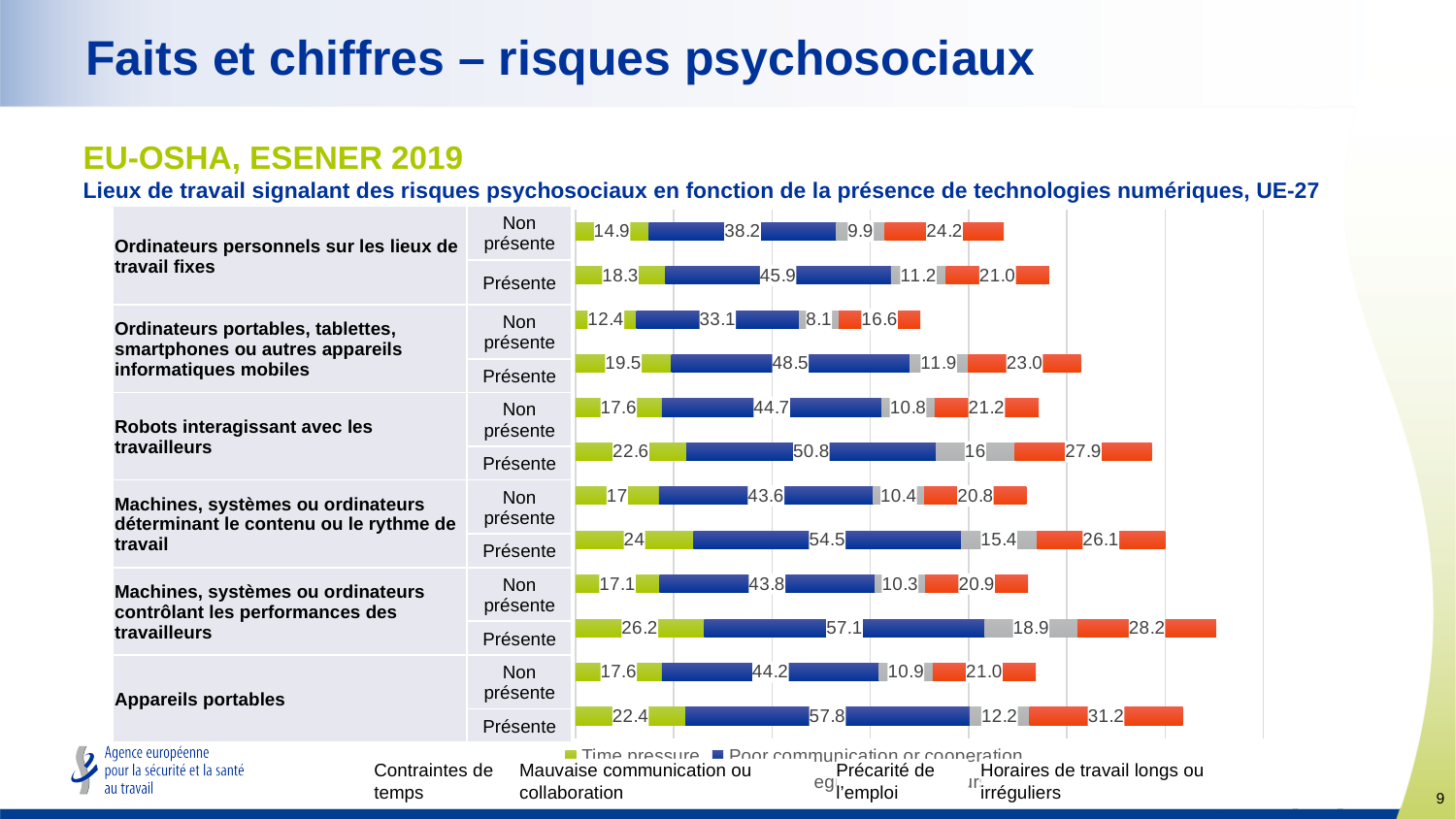
For 'Appareils portables', what is the value of 'Mauvaise communication ou collaboration' when the technology is 'Présente'? 57.8 For 'Ordinateurs personnels sur les lieux de travail fixes', what is the value of 'Mauvaise communication ou collaboration' when the technology is 'Présente'? 45.9 For 'Robots interagissant avec les travailleurs', what is the value of 'Horaires de travail longs ou irréguliers' when the technology is 'Présente'? 27.9 Which bar has the highest value for 'Mauvaise communication ou collaboration'? Appareils portables, Présente Which bar has the lowest value for 'Contraintes de temps'? Ordinateurs portables, tablettes, smartphones ou autres appareils informatiques mobiles, Non présente How many stacked bars are shown in the chart? 12 For 'Horaires de travail longs ou irréguliers' with the technology 'Présente', which is larger: 'Appareils portables' or 'Machines, systèmes ou ordinateurs contrôlant les performances des travailleurs'? Appareils portables For 'Ordinateurs portables, tablettes, smartphones ou autres appareils informatiques mobiles', what is the difference in 'Mauvaise communication ou collaboration' between 'Présente' and 'Non présente'? 15.4 For 'Machines, systèmes ou ordinateurs contrôlant les performances des travailleurs', what is the value of 'Contraintes de temps' when the technology is 'Présente'? 26.2 How many series does the chart's legend list? 4 What is the total of the stacked bar for 'Ordinateurs personnels sur les lieux de travail fixes', 'Non présente'? 87.2 What kind of chart is shown on the slide? Stacked bar chart